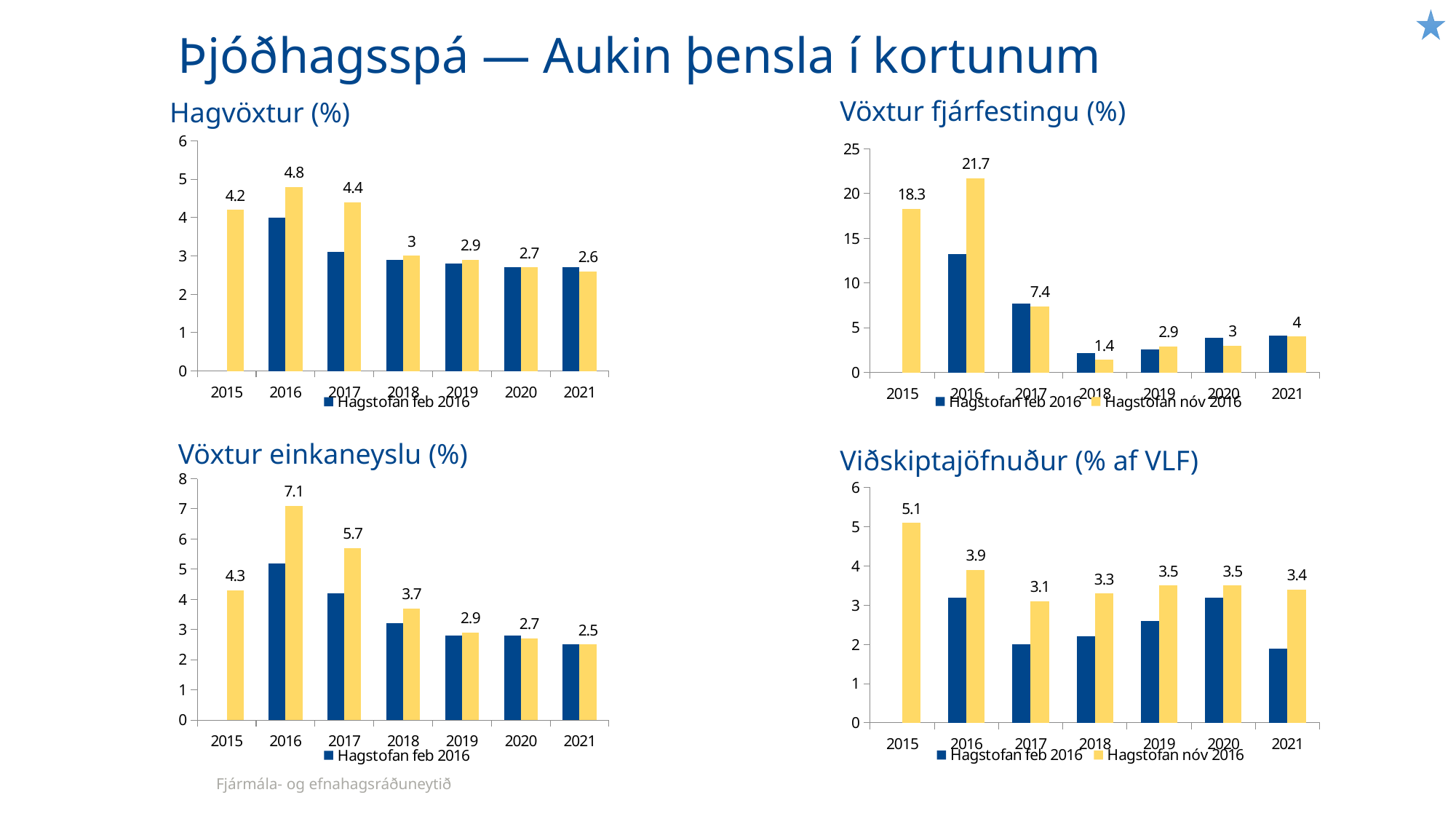
In the 'Vöxtur fjárfestingu (%)' chart, is the Hagstofan feb 2016 value for 2016 greater or less than 10? greater In the 'Vöxtur einkaneyslu (%)' chart, what is the labelled value for 2017? 5.7 In the 'Vöxtur fjárfestingu (%)' chart, which year has the lowest labelled value? 2018 In the 'Vöxtur fjárfestingu (%)' chart, what is the labelled value for 2015? 18.3 How many years are shown on the x axis of the 'Hagvöxtur (%)' chart? 7 In the 'Hagvöxtur (%)' chart, which year has the highest labelled Hagstofan nóv 2016 value? 2016 In the 'Viðskiptajöfnuður (% af VLF)' chart, what is the labelled value for 2015? 5.1 How many series does the legend of the 'Viðskiptajöfnuður (% af VLF)' chart list? 2 In the 'Vöxtur fjárfestingu (%)' chart, what is the difference between the labelled values for 2016 and 2017? 14.3 In the 'Viðskiptajöfnuður (% af VLF)' chart, which is larger: the labelled value for 2016 or for 2017? 2016 In the 'Hagvöxtur (%)' chart, what is the Hagstofan nóv 2016 value for 2016? 4.8